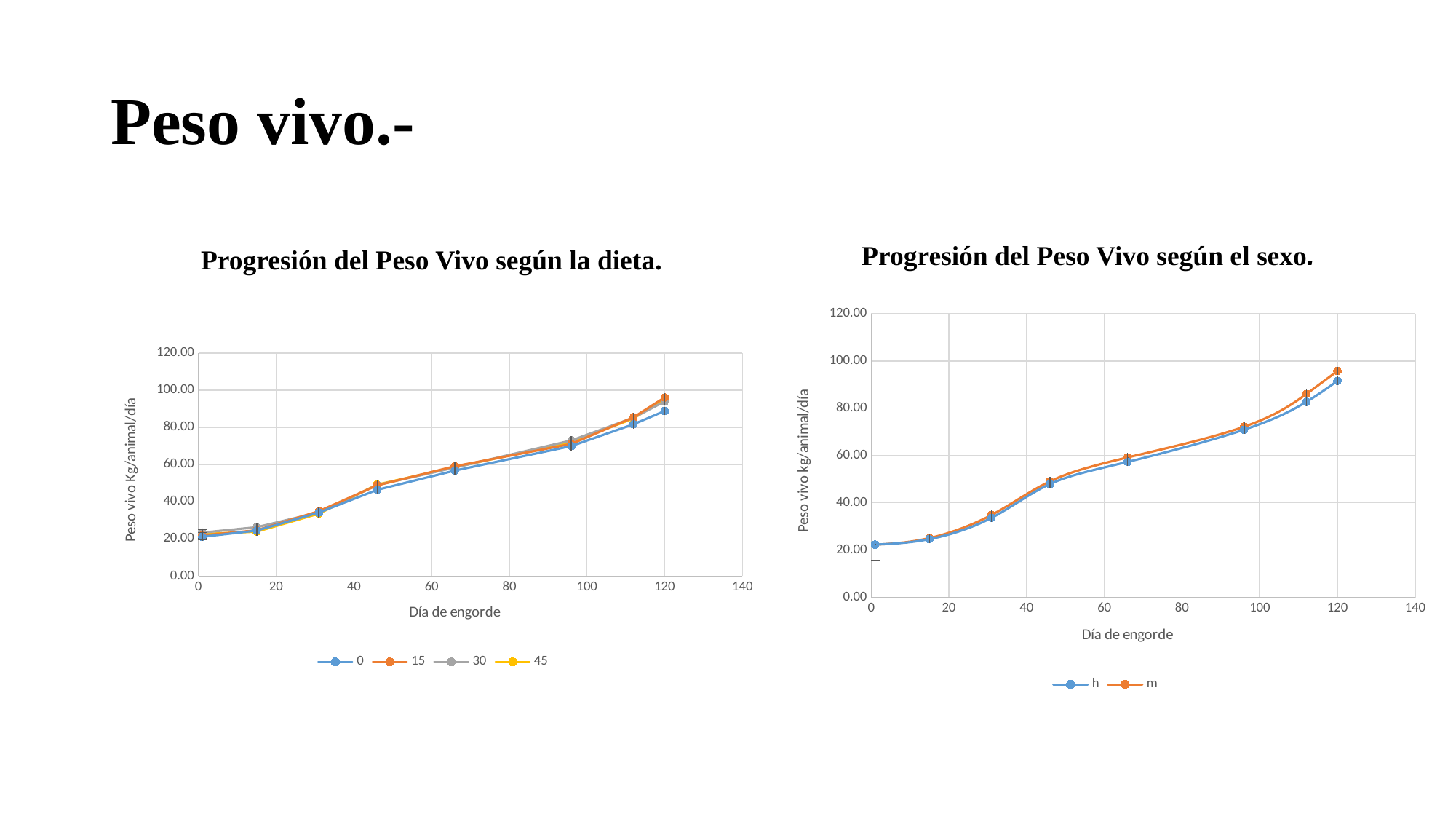
What kind of chart is 'Progresión del Peso Vivo según la dieta.'? line chart In 'Progresión del Peso Vivo según el sexo.', is the value for series 'm' at day 120 greater or less than 80? greater In 'Progresión del Peso Vivo según el sexo.', is the value for series 'h' at day 46 greater or less than 40? greater In 'Progresión del Peso Vivo según el sexo.', which series has the higher value at day 120, 'h' or 'm'? m In 'Progresión del Peso Vivo según la dieta.', do the values rise or fall along the x axis? rise In 'Progresión del Peso Vivo según el sexo.', do the values rise or fall as 'Día de engorde' increases? rise How many data points does each series have in 'Progresión del Peso Vivo según el sexo.'? 8 In 'Progresión del Peso Vivo según la dieta.', is the value for series '0' at day 120 greater or less than 100? less How many series does the legend of 'Progresión del Peso Vivo según el sexo.' list? 2 What is the y-axis label of 'Progresión del Peso Vivo según el sexo.'? Peso vivo kg/animal/día In 'Progresión del Peso Vivo según la dieta.', which series has the higher value at day 120, '0' or '15'? 15 How many series does the legend of 'Progresión del Peso Vivo según la dieta.' list? 4